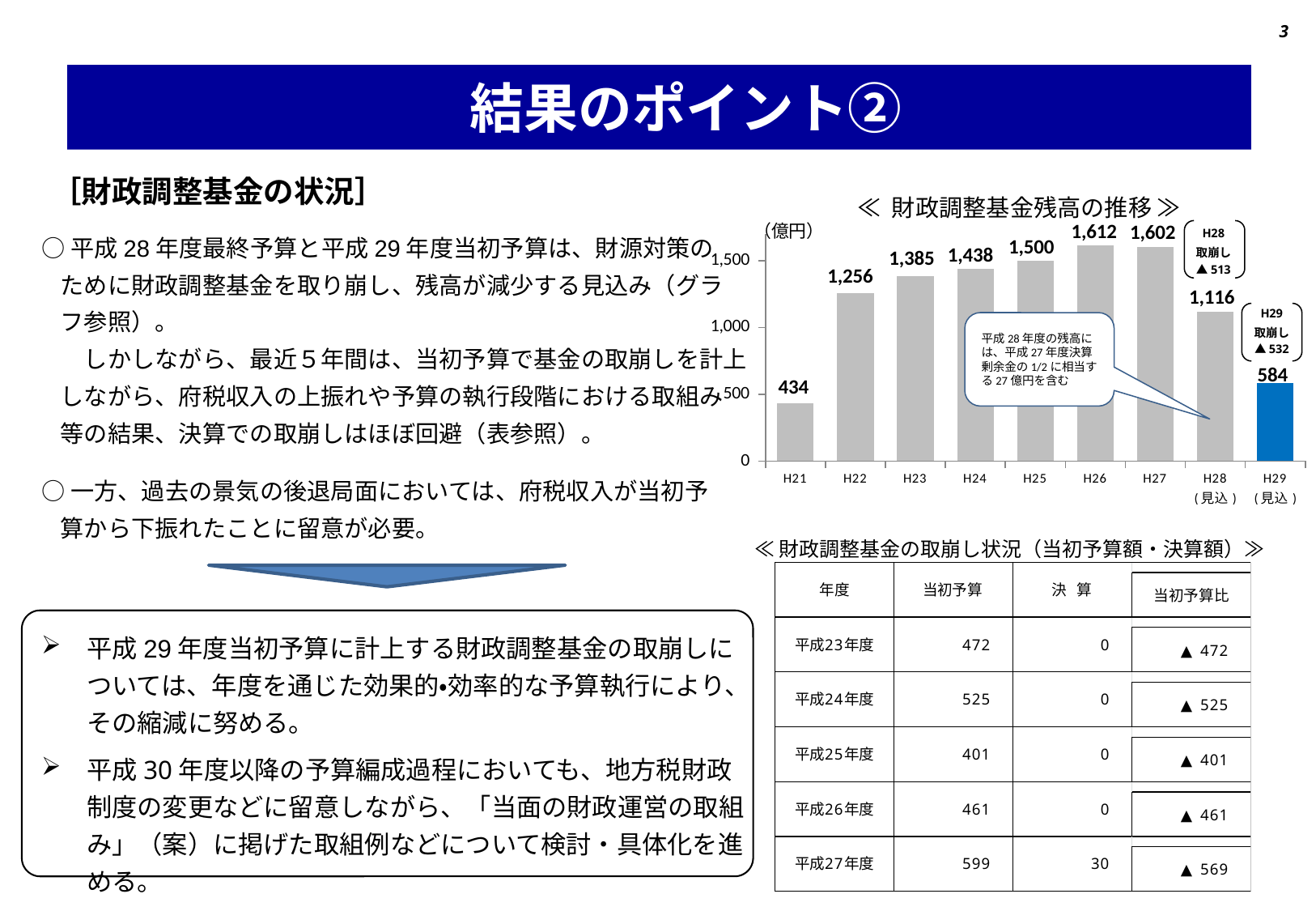
In the 財政調整基金残高の推移 chart, what is the value for H21? 434 In the 財政調整基金残高の推移 chart, which year has the highest value? H26 In the 財政調整基金残高の推移 chart, what is the value for H28（見込）? 1,116 In the 財政調整基金残高の推移 chart, which is larger, the value for H22 or the value for H23? H23 What type of chart is 財政調整基金残高の推移? bar chart In the 財政調整基金残高の推移 chart, is the value for H24 greater or less than 1,000? greater In the 財政調整基金残高の推移 chart, what is the value for H26? 1,612 How many years (bars) are shown in the 財政調整基金残高の推移 chart? 9 In the 財政調整基金残高の推移 chart, what is the difference between the values for H27 and H28（見込）? 486 In the 財政調整基金残高の推移 chart, which year has the lowest value? H21 In the 財政調整基金残高の推移 chart, what is the value for H29（見込）? 584 What unit is shown on the axis of the 財政調整基金残高の推移 chart? 億円